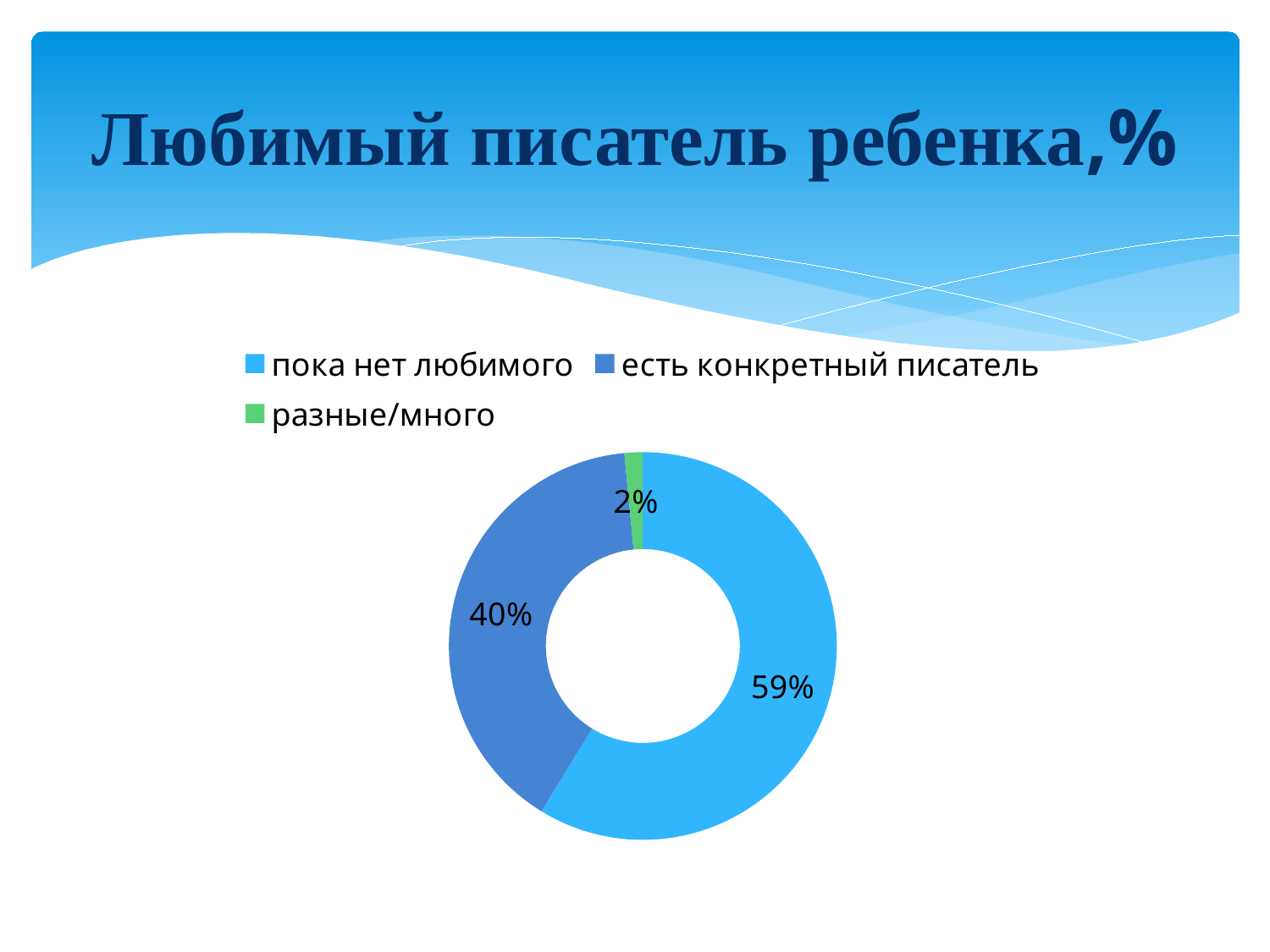
What is the title of the slide? Любимый писатель ребенка,% What kind of chart is shown on the slide? Doughnut chart Which category has the smallest share? разные/много What colour is the slice for "разные/много"? Green What is the value for "есть конкретный писатель"? 40% Which category has the largest share? пока нет любимого How many categories does the chart show? 3 What is the difference between the shares of "пока нет любимого" and "есть конкретный писатель"? 19% Which is larger: the share for "есть конкретный писатель" or for "разные/много"? есть конкретный писатель What is the value for "разные/много"? 2% What share of the chart does "пока нет любимого" take? 59% What is the difference between the shares of "есть конкретный писатель" and "разные/много"? 38%